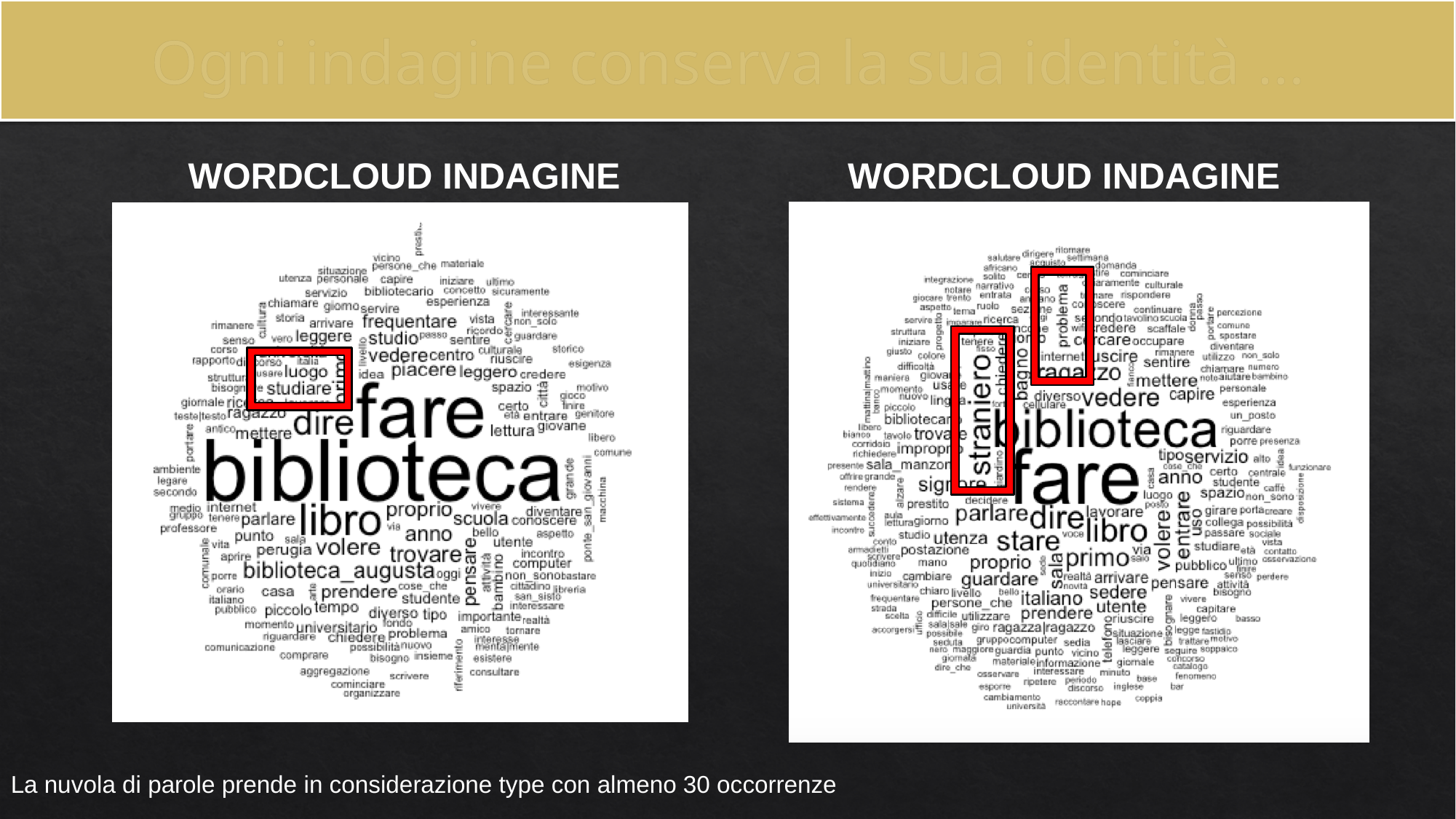
What kind of chart is shown on the left side of the slide? Word cloud In the left word cloud, which word is shown larger, "fare" or "libro"? fare In the right word cloud, which word is shown larger, "stare" or "sedia"? stare In the left word cloud, which word appears largest (most frequent)? biblioteca What is the title shown above each word cloud? WORDCLOUD INDAGINE How many word clouds are shown on the slide? 2 In the right word cloud, which word is shown larger, "biblioteca" or "fare"? fare In the right word cloud, which word appears largest (most frequent)? fare In the right word cloud, which two words are highlighted with red boxes? straniero and problema